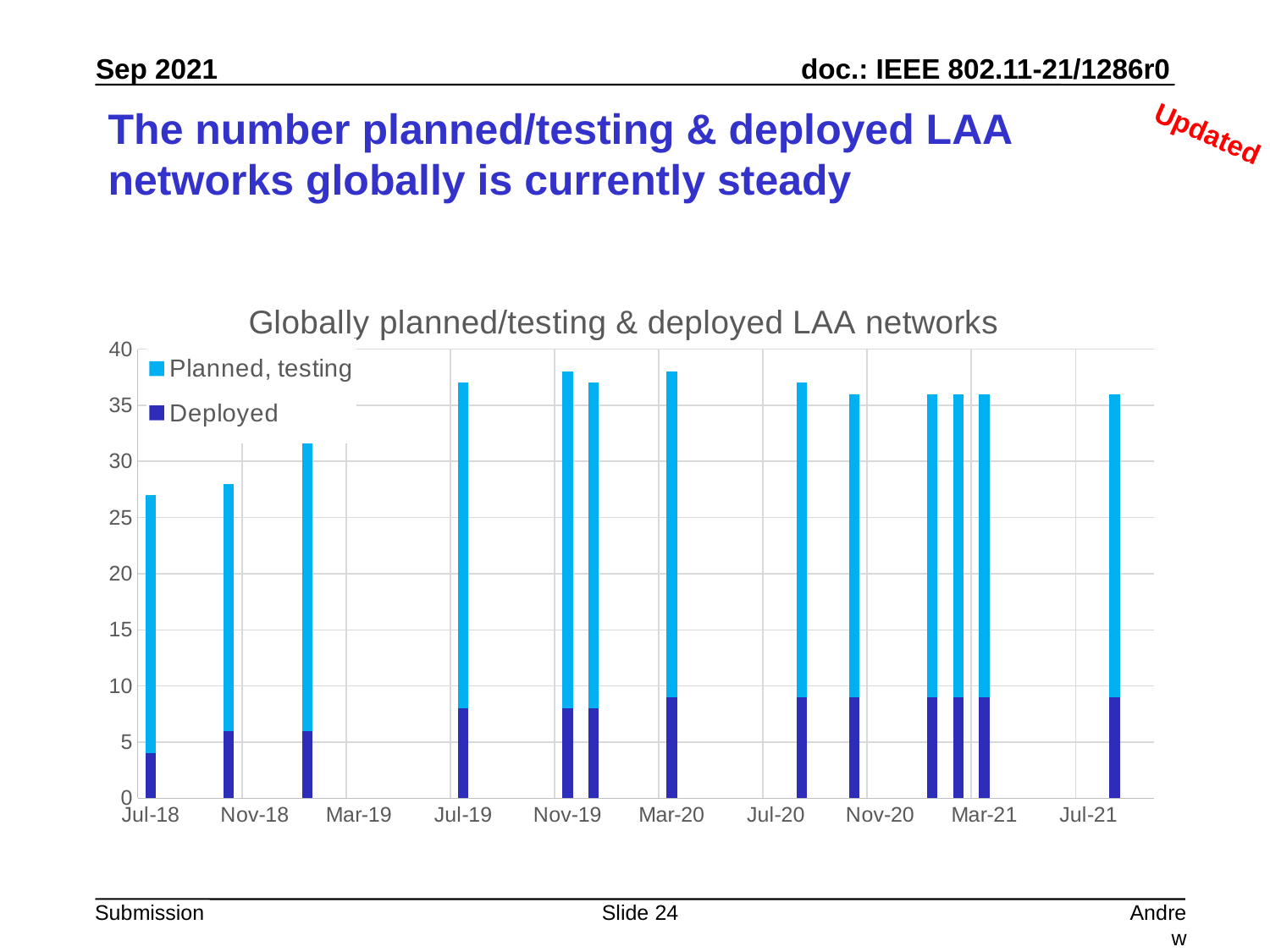
Which bar is taller in total, Jul-18 or Mar-20? Mar-20 What kind of chart is shown on the slide? Stacked bar chart How many series does the chart's legend list? 2 Is the Deployed value for Jul-18 greater or less than 5? less What is the title of the chart? Globally planned/testing & deployed LAA networks Is the total height of the Jul-18 bar greater or less than 30? less Is the Deployed value for Jul-19 greater or less than 10? less Which series is shown in dark blue in the chart? Deployed Which has the larger Deployed value, Jul-18 or Mar-21? Mar-21 Do the total bar heights rise or fall from Jul-18 to Jul-19? rise